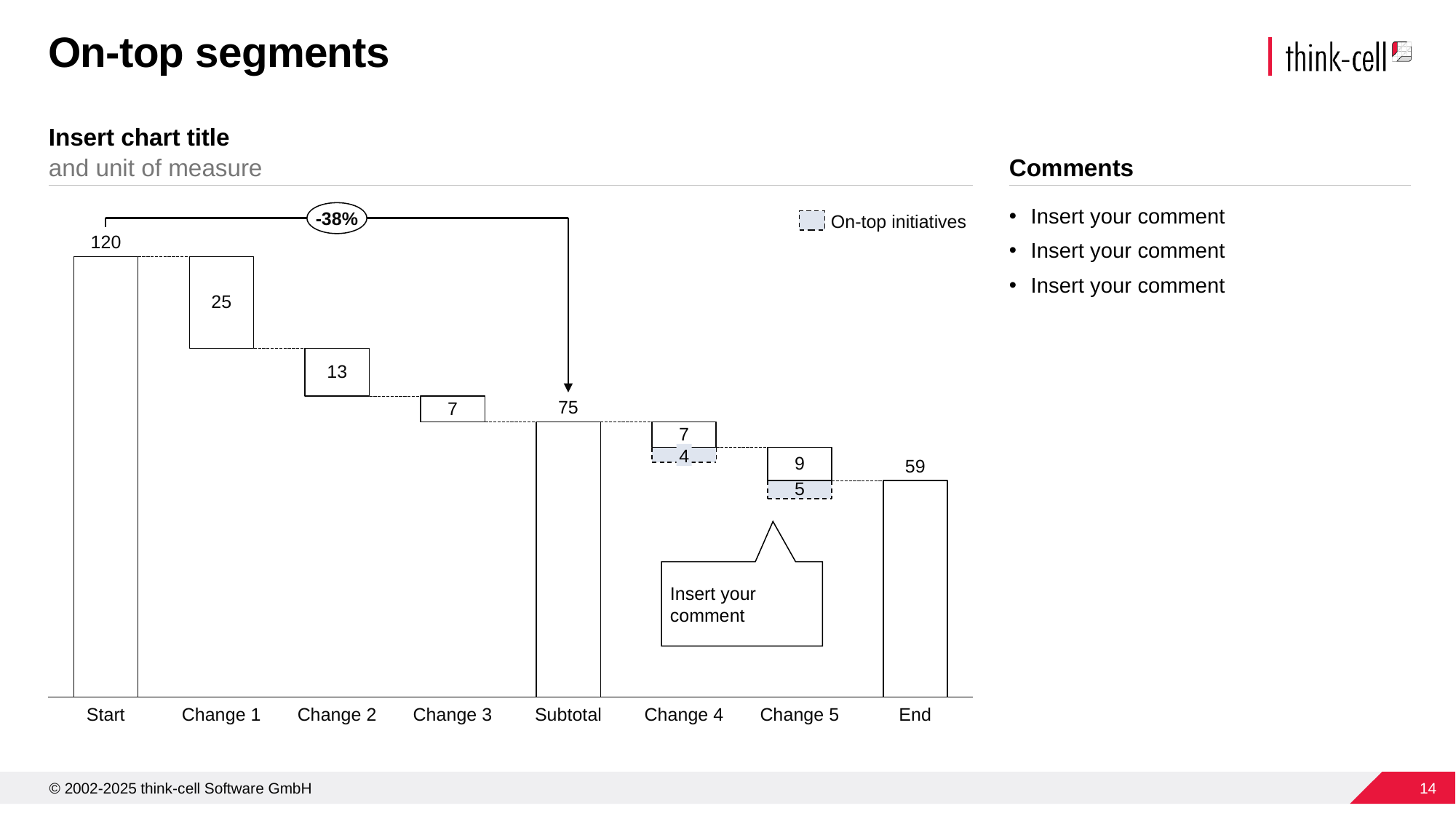
Which is larger, the value for Change 1 or the value for Change 2? Change 1 What is the value of the on-top segment for Change 4? 4 What is the value of the on-top segment for Change 5? 5 What is the difference between the Start value and the Subtotal value? 45 What is the value of the Start bar? 120 What is the value of the Subtotal bar? 75 Which category has the highest bar? Start What is the value shown for Change 1? 25 What is the value of the End bar? 59 What percentage change is shown by the arrow from Start to Subtotal? -38% What does the legend entry with the dashed, shaded box represent? On-top initiatives How many categories are shown on the x axis? 8